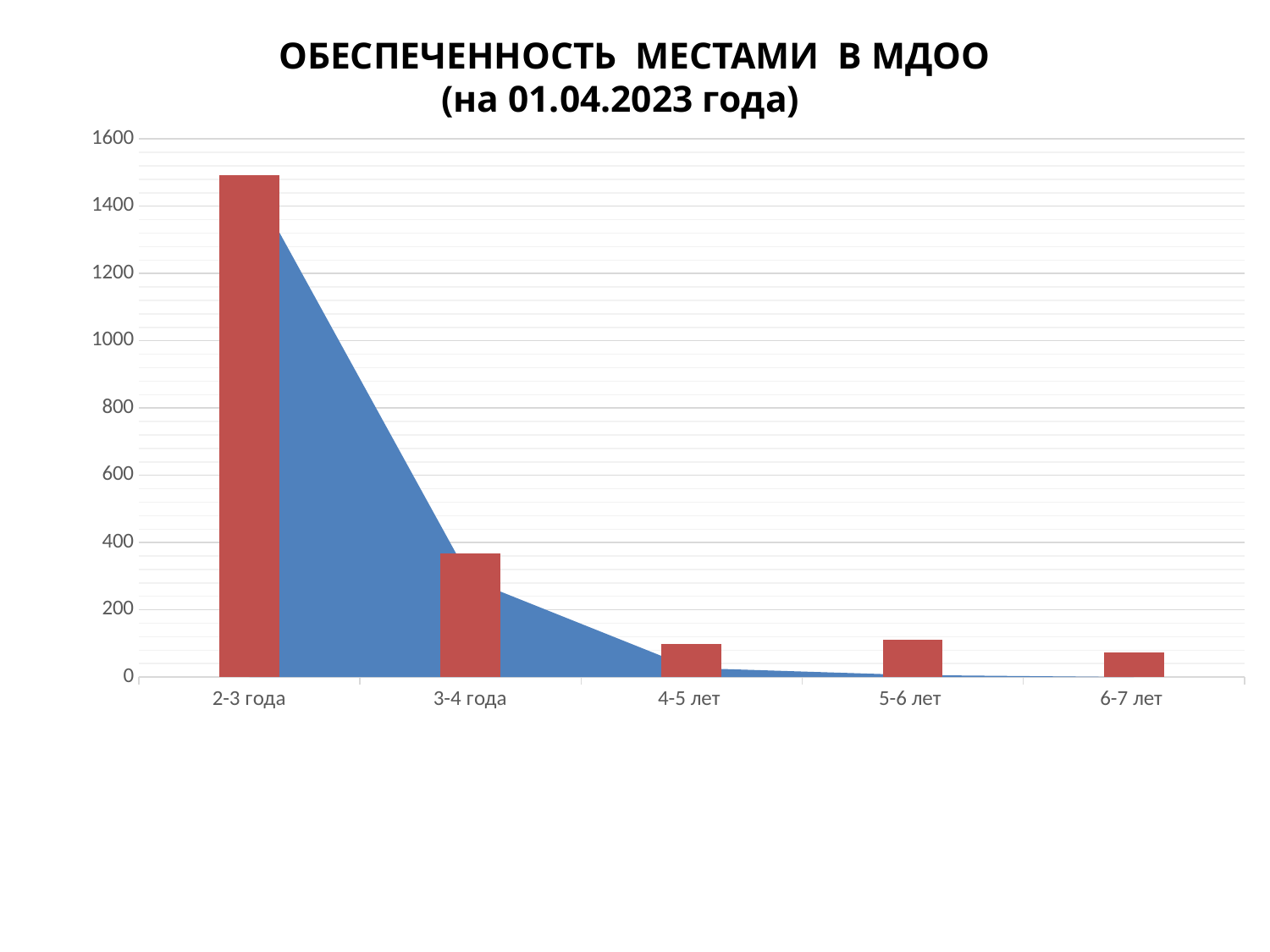
Which age category has the highest bar? 2-3 года How many age categories are shown on the x axis? 5 Is the bar value for 4-5 лет greater or less than 200? less Is the bar value for 3-4 года greater or less than 200? greater What colour are the bars in the chart? red Is the bar value for 2-3 года greater or less than 1400? greater What kind of chart is shown on the slide? bar chart (with an area series) Which has the larger bar, 2-3 года or 3-4 года? 2-3 года Do the bar values rise or fall from 2-3 года to 4-5 лет? fall What date is given in the chart title? 01.04.2023